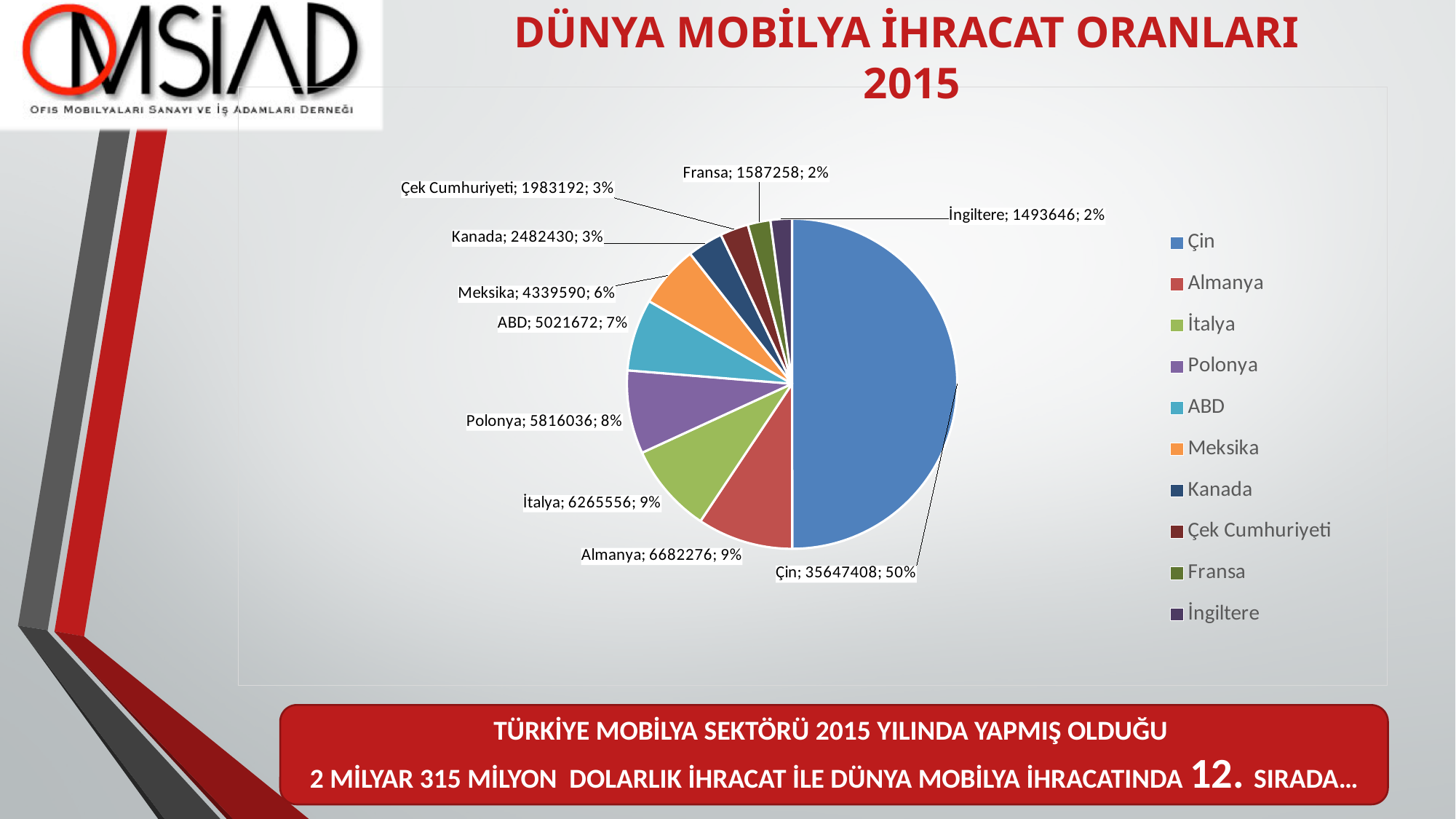
What kind of chart is shown on the slide? pie chart How many countries are shown in the pie chart? 10 What share of the pie does Çin represent? 50% What is the value for Çin? 35647408 What share of the pie does Polonya represent? 8% What is the difference between the values for Çin and Almanya? 28965132 What is the title of the chart? DÜNYA MOBİLYA İHRACAT ORANLARI 2015 What is the value for Meksika? 4339590 Which is larger, the value for Almanya or the value for İtalya? Almanya What is the difference between the values for Polonya and ABD? 794364 Which country has the largest slice? Çin Which country has the smallest slice? İngiltere